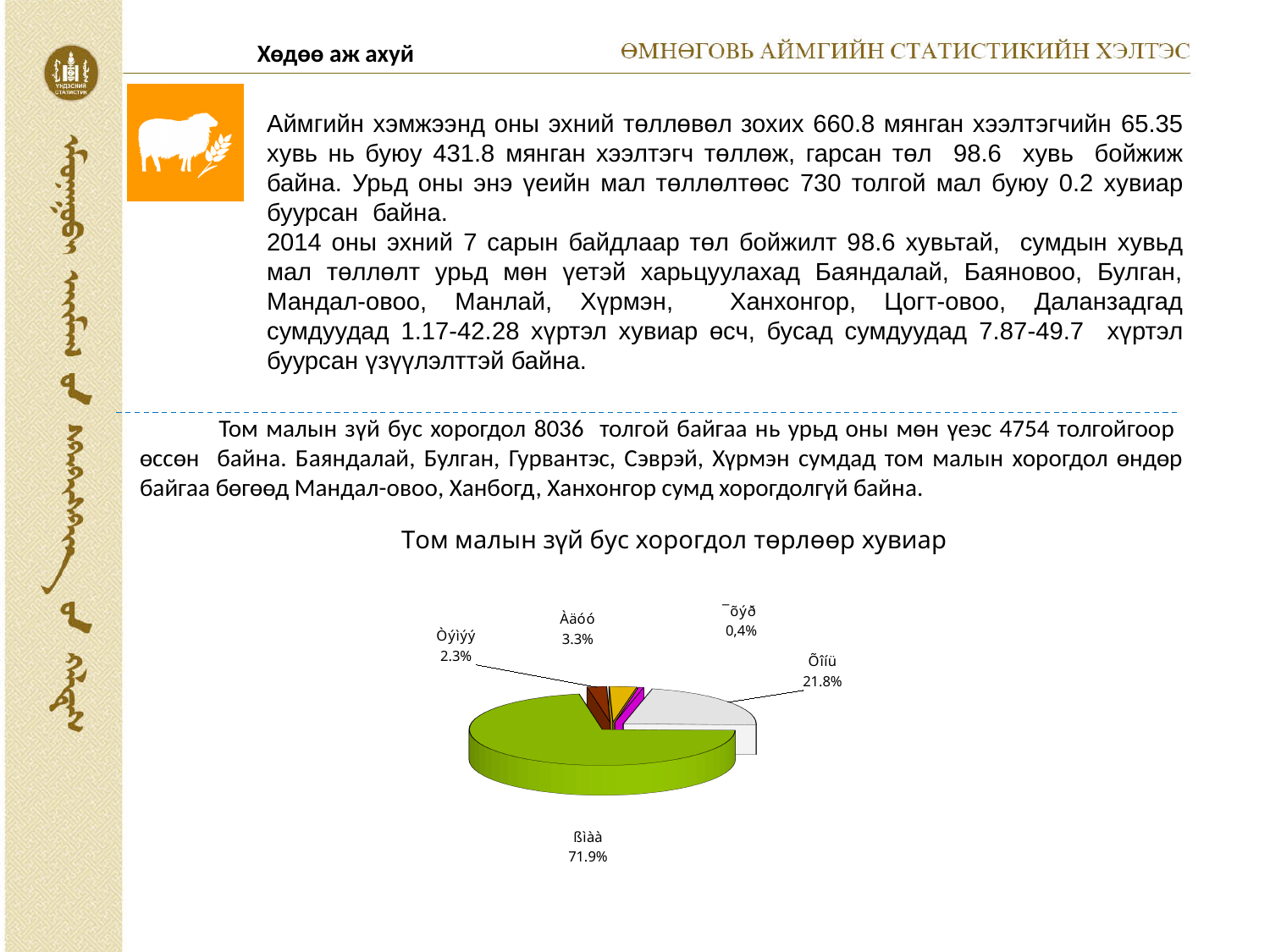
What share is shown for the slice labelled "Õîíü"? 21.8% What is the share of the smallest slice in the pie chart? 0,4% How many slices does the pie chart have? 5 What colour is the largest slice of the pie chart? Green What is the difference in percentage points between the slices labelled "Àäóó" and "Òýìýý"? 1.0 percentage point What kind of chart is shown on the slide? Pie chart What is the difference in percentage points between the largest slice (71.9%) and the slice labelled "Õîíü" (21.8%)? 50.1 percentage points What is the share of the largest slice in the pie chart? 71.9% What share is shown for the slice labelled "Òýìýý"? 2.3% What share is shown for the slice labelled "Àäóó"? 3.3% Which slice is larger, the one labelled "Àäóó" or the one labelled "Òýìýý"? Àäóó What is the title of the chart on the slide? Том малын зүй бус хорогдол төрлөөр хувиар